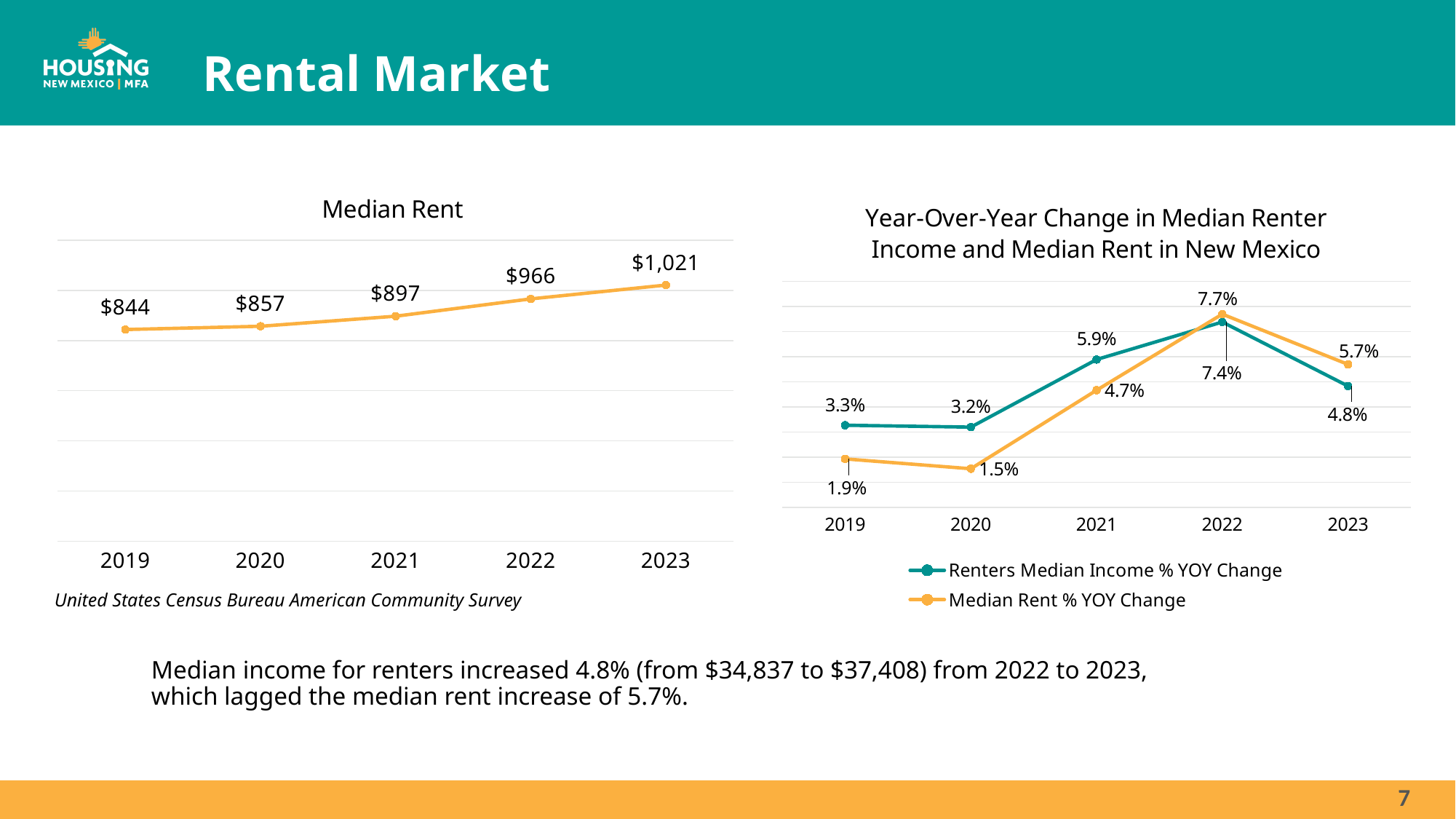
In the Median Rent chart, what is the median rent for 2021? $897 In the Year-Over-Year Change chart, which year has the lowest Median Rent % YOY Change? 2020 In the Median Rent chart, do the values rise or fall from 2019 to 2023? rise In the Year-Over-Year Change chart, what is the Median Rent % YOY Change for 2020? 1.5% In the Median Rent chart, how many years are plotted? 5 In the Median Rent chart, which year has the highest median rent? 2023 In the Median Rent chart, what is the difference between the median rent in 2023 and in 2019? $177 In the Year-Over-Year Change chart, what is the difference between the Median Rent % YOY Change and the Renters Median Income % YOY Change in 2023? 0.9% In the Year-Over-Year Change chart, what is the Renters Median Income % YOY Change for 2022? 7.4% In the Year-Over-Year Change chart, how many series does the legend list? 2 What kind of chart is the Median Rent chart? line chart In the Year-Over-Year Change chart, which is larger in 2021: Renters Median Income % YOY Change or Median Rent % YOY Change? Renters Median Income % YOY Change